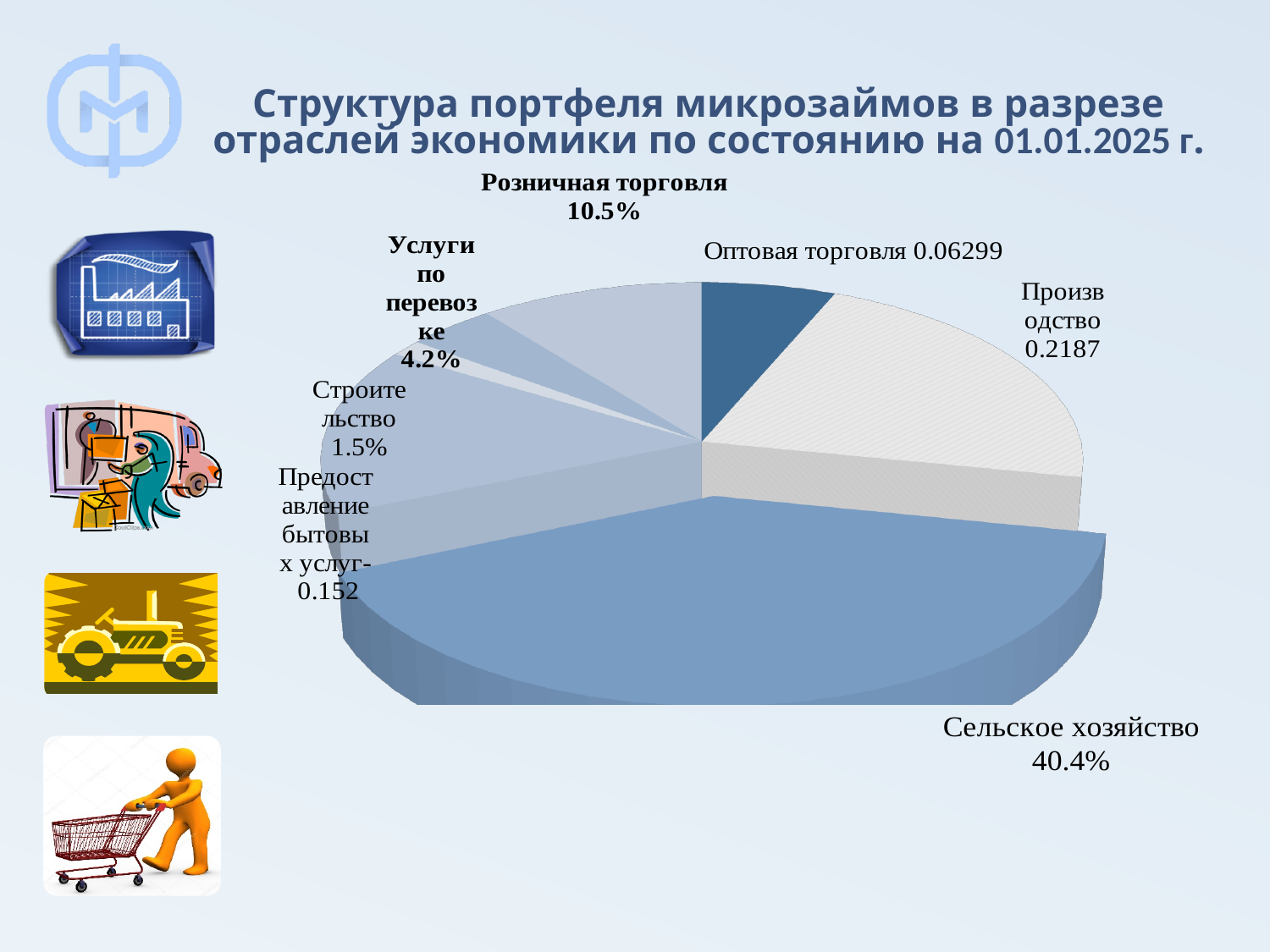
What is the value shown for Розничная торговля? 10.5% What is the value shown for Оптовая торговля? 0.06299 What is the value shown for Сельское хозяйство? 40.4% Which is larger, the share for Производство or the share for Розничная торговля? Производство How many sectors (slices) are shown in the pie chart? 7 What is the value shown for Предоставление бытовых услуг? 0.152 What is the difference between the shares of Сельское хозяйство and Розничная торговля? 29.9 percentage points What is the value shown for Услуги по перевозке? 4.2% What is the value shown for Производство? 0.2187 Which sector has the smallest share of the pie? Строительство What kind of chart is shown on the slide? Pie chart Which sector has the largest share of the pie? Сельское хозяйство